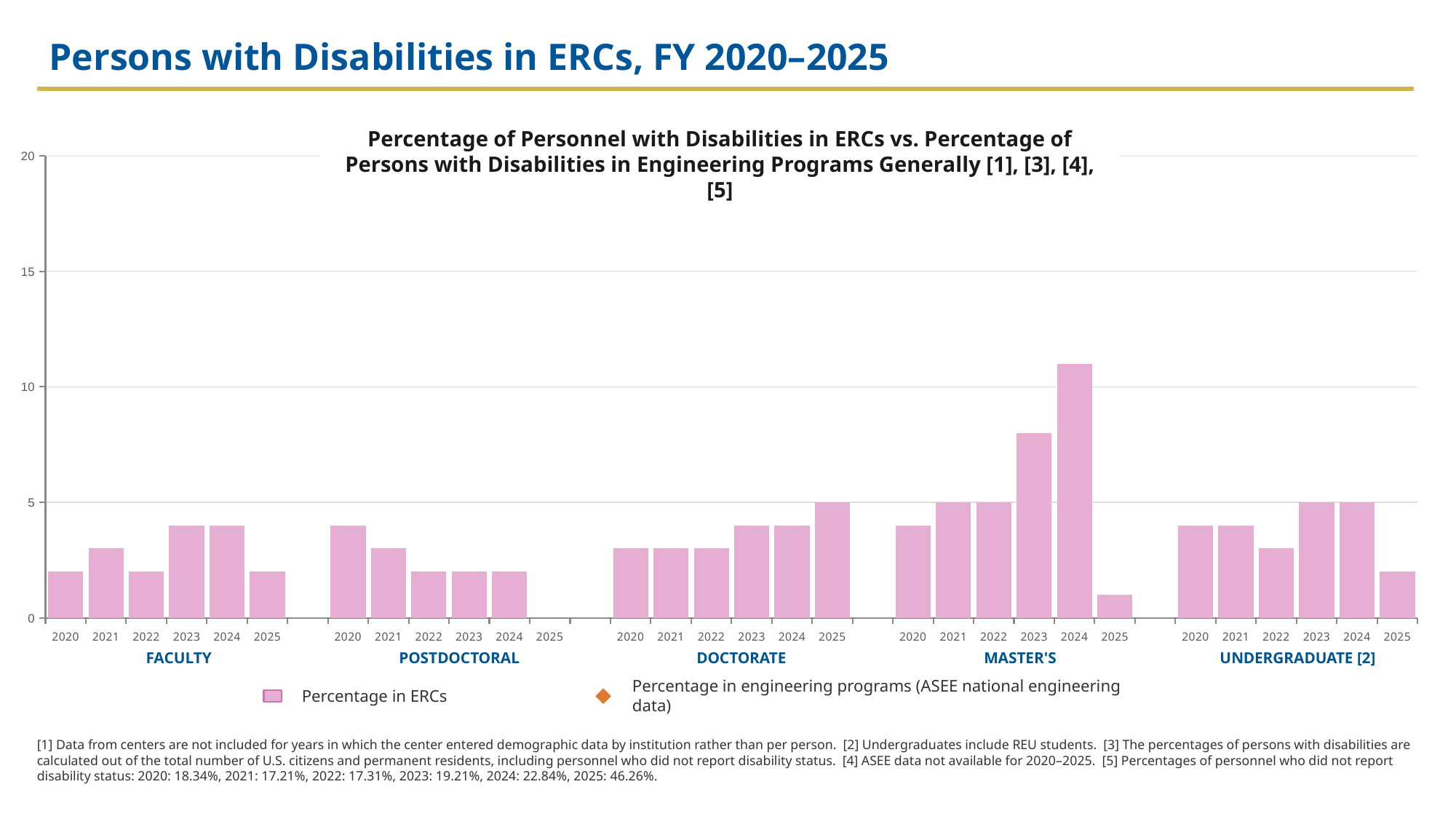
What does the pink bar in the legend represent? Percentage in ERCs What kind of chart is shown on the slide? bar chart Within the Postdoctoral group, which year has the highest percentage in ERCs? 2020 Is the value for Master's 2024 greater or less than 10? greater How many personnel groups are shown along the x axis? 5 Is the value for Faculty 2020 greater or less than 5? less Which personnel group and year has the highest percentage in ERCs on the chart? Master's 2024 How many series does the legend list? 2 Within the Master's group, which year has the lowest percentage in ERCs? 2025 Which is larger, the value for Master's 2024 or the value for Doctorate 2025? Master's 2024 How many fiscal years are shown for each personnel group? 6 Is the value for Master's 2023 greater or less than 5? greater